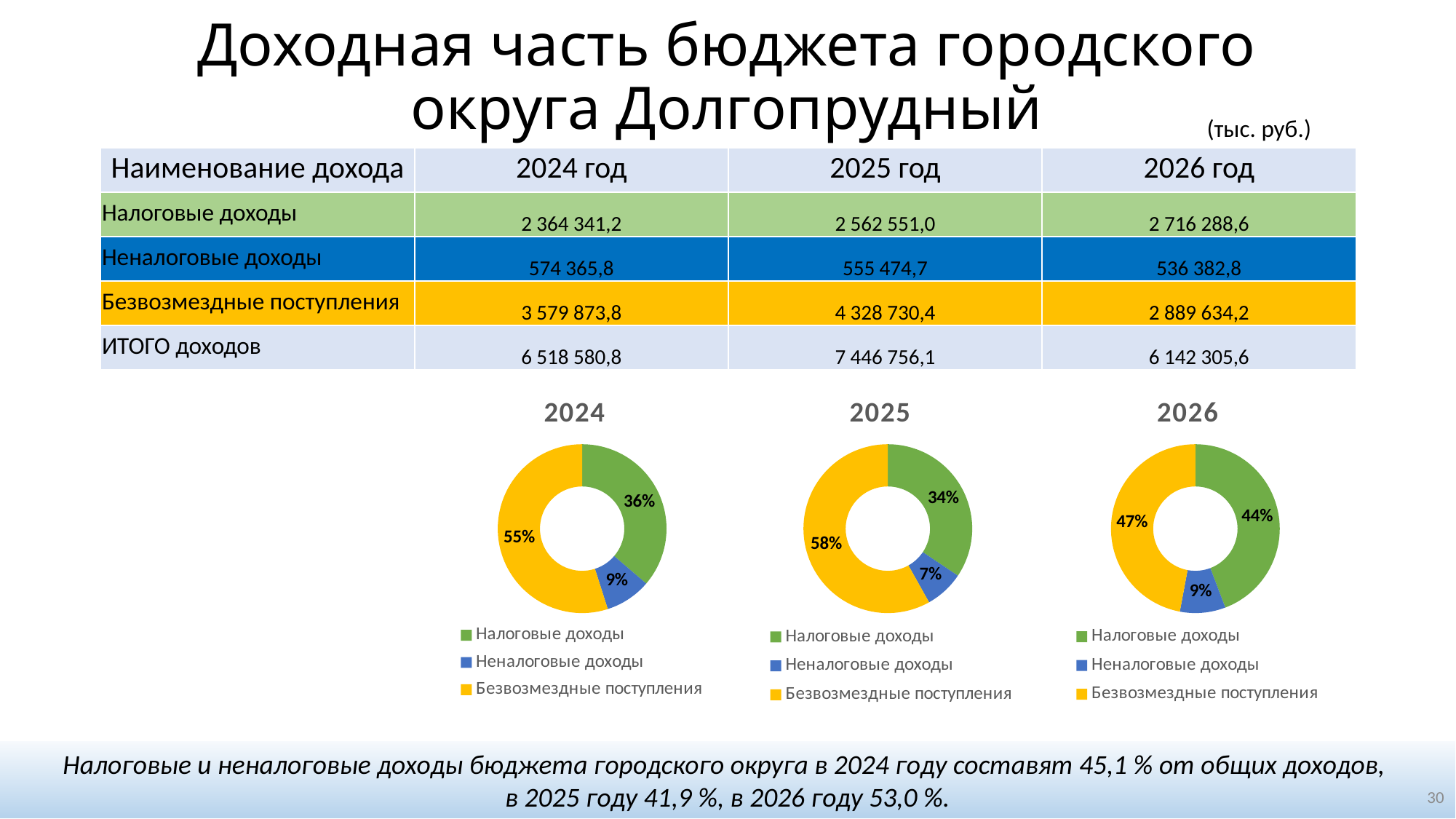
In the 2025 chart, which category has the largest slice? Безвозмездные поступления In the 2024 chart, what is the difference between the shares of Безвозмездные поступления and Налоговые доходы? 19% In the 2024 chart, what share is labelled for Налоговые доходы? 36% In the 2026 chart, which category has the smallest slice? Неналоговые доходы How many entries does the legend of the 2024 chart list? 3 In the 2026 chart, what share is labelled for Безвозмездные поступления? 47% How many slices does the 2025 chart have? 3 What is the title of the leftmost chart on the slide? 2024 In the 2026 chart, which is larger: the share of Налоговые доходы or the share of Неналоговые доходы? Налоговые доходы In the 2024 chart, what colour is the slice for Безвозмездные поступления? Yellow In the 2025 chart, what share is labelled for Неналоговые доходы? 7% What type of chart is the 2026 chart? Doughnut chart